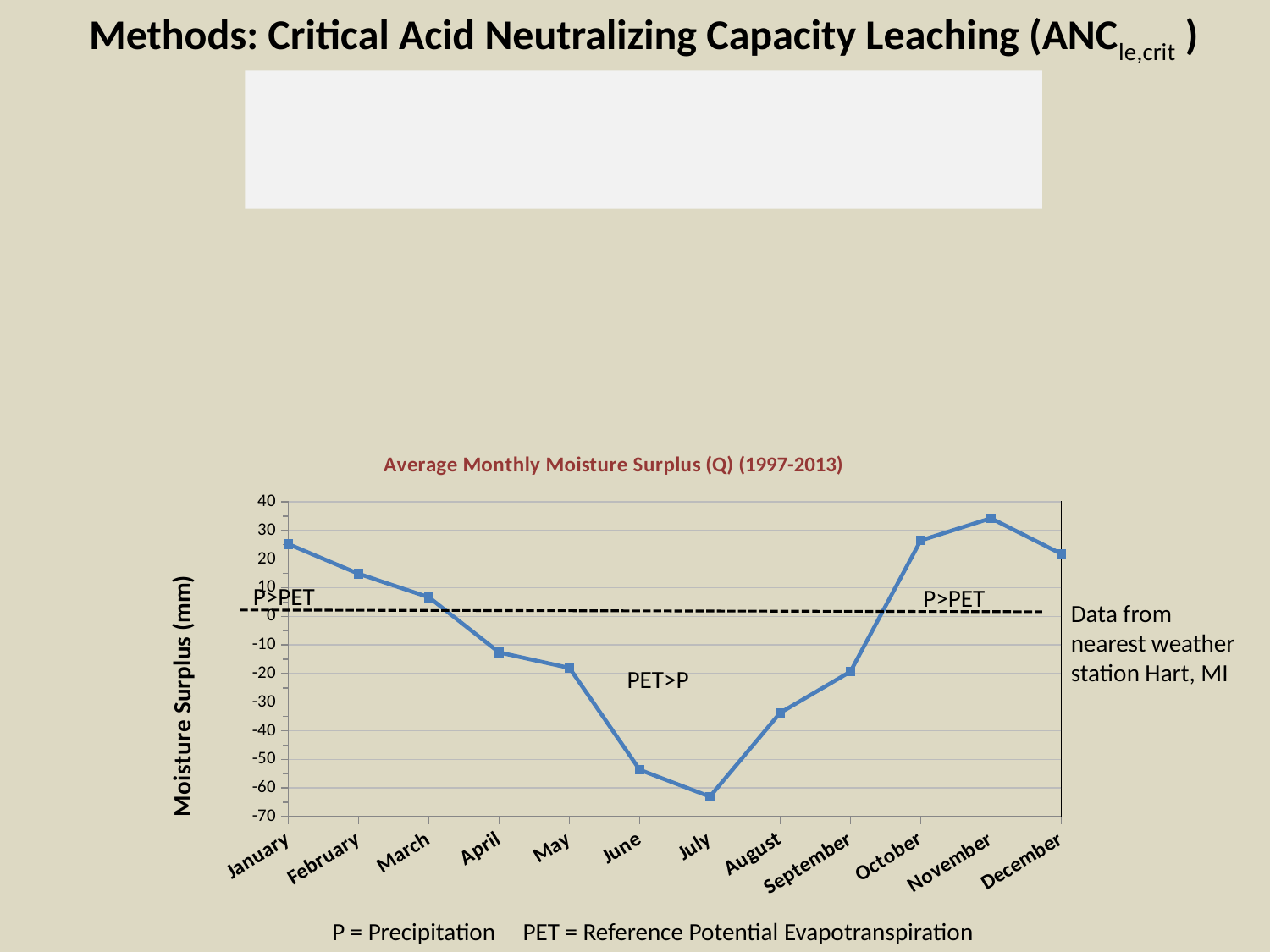
Which month has the highest moisture surplus? November Is the value for June greater or less than -50? less What kind of chart is shown on the slide? line chart What is the title of the chart? Average Monthly Moisture Surplus (Q) (1997-2013) How many months are plotted along the x axis of the chart? 12 Is the value for August greater or less than -30? less Which month has the lowest moisture surplus? July What is the label on the y axis of the chart? Moisture Surplus (mm) Is the value for January greater or less than 20? greater Which has a higher moisture surplus, October or December? October Do the values rise or fall from January to July? fall